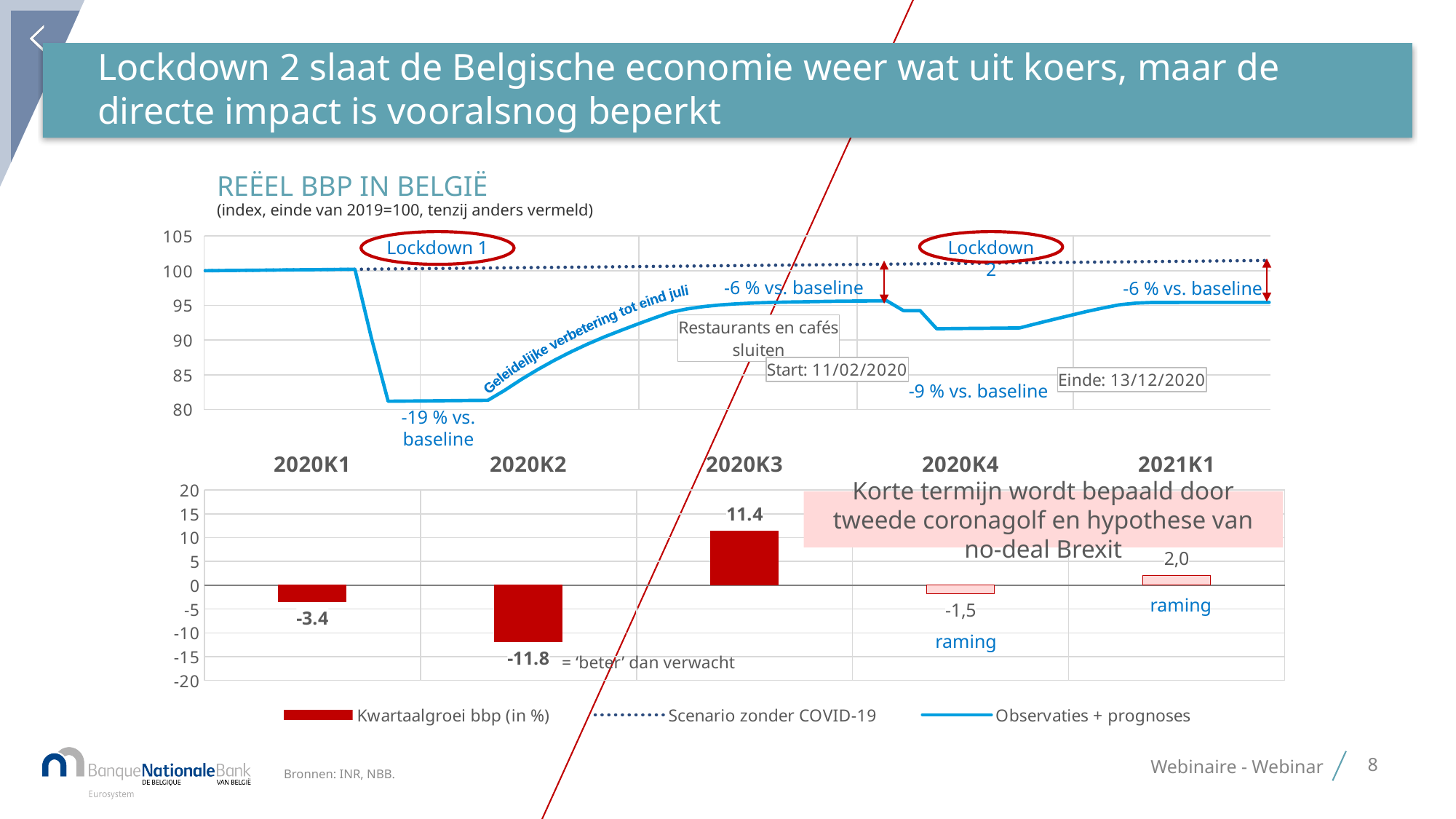
In the bottom bar chart (Kwartaalgroei bbp), what is the difference between the values for 2020K3 and 2020K2? 23.2 How many series does the legend at the bottom of the slide list? 3 What kind of chart is the bottom chart showing Kwartaalgroei bbp? bar chart In the bottom bar chart (Kwartaalgroei bbp), which is larger: the value for 2020K1 or the value for 2020K4? 2020K4 In the bottom bar chart (Kwartaalgroei bbp), what is the value for 2021K1? 2,0 How many quarters are shown on the x axis of the bottom bar chart? 5 In the bottom bar chart (Kwartaalgroei bbp), what is the value for 2020K1? -3.4 In the bottom bar chart (Kwartaalgroei bbp), which quarter has the highest value? 2020K3 In the bottom bar chart (Kwartaalgroei bbp), what is the value for 2020K3? 11.4 In the bottom bar chart (Kwartaalgroei bbp), what is the value for 2020K2? -11.8 In the bottom bar chart (Kwartaalgroei bbp), which quarter has the lowest value? 2020K2